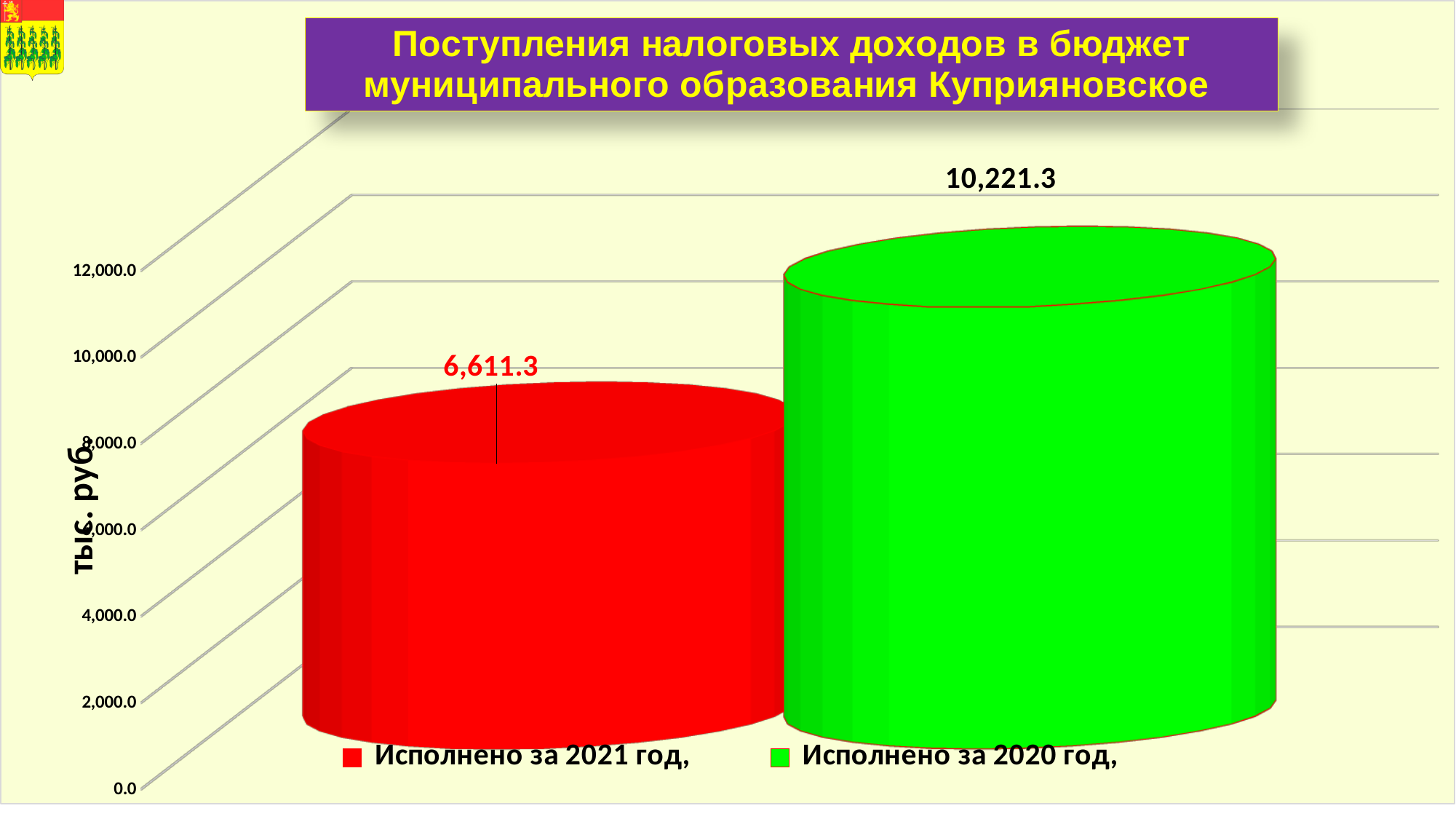
What is the title of the chart? Поступления налоговых доходов в бюджет муниципального образования Куприяновское How many series does the legend list? 2 What is the value for "Исполнено за 2021 год"? 6,611.3 Which series has the higher value, "Исполнено за 2021 год" or "Исполнено за 2020 год"? Исполнено за 2020 год Which series has the lowest value? Исполнено за 2021 год Is the value for "Исполнено за 2020 год" greater or less than 10,000.0? greater What is the difference between the value for 2020 (10,221.3) and the value for 2021 (6,611.3)? 3,610.0 What is the value for "Исполнено за 2020 год"? 10,221.3 Which series has the highest value? Исполнено за 2020 год Is the value for "Исполнено за 2021 год" greater or less than 8,000.0? less What colour is the bar for "Исполнено за 2020 год"? Green What kind of chart is shown on the slide? Bar chart